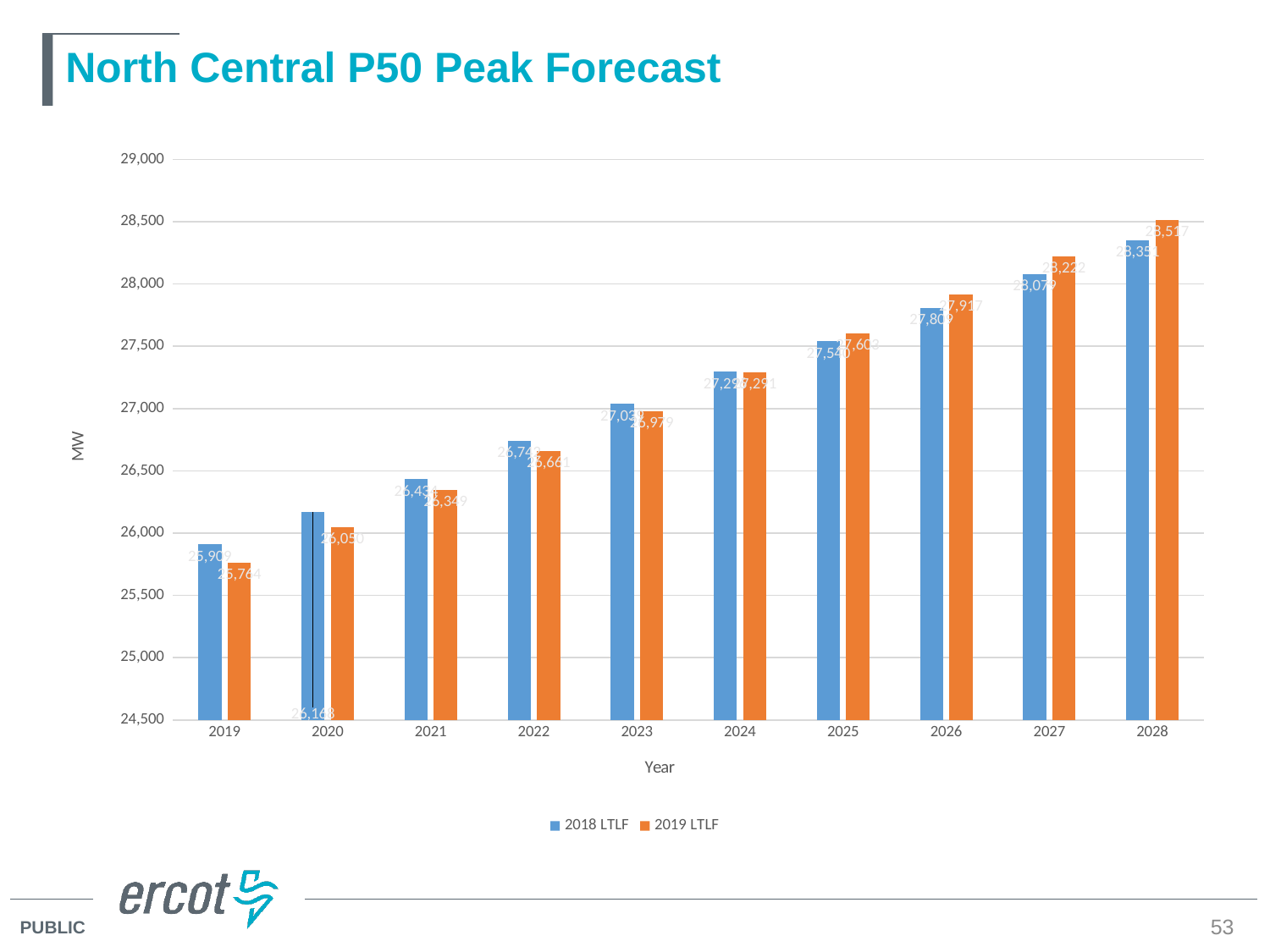
Do the 2019 LTLF values rise or fall from 2019 to 2028? rise For 2019, which series is larger, 2018 LTLF or 2019 LTLF? 2018 LTLF Is the 2018 LTLF value for 2019 greater or less than 26,000? less Which year has the lowest 2018 LTLF value? 2019 How many series does the legend list? 2 What kind of chart is shown on the slide? bar chart What is the 2019 LTLF value for 2028? 28,517 How many years are shown on the x axis? 10 What is the 2019 LTLF value for 2027? 28,222 What is the 2018 LTLF value for 2019? 25,909 Which year has the highest 2019 LTLF value? 2028 What is the 2019 LTLF value for 2019? 25,764